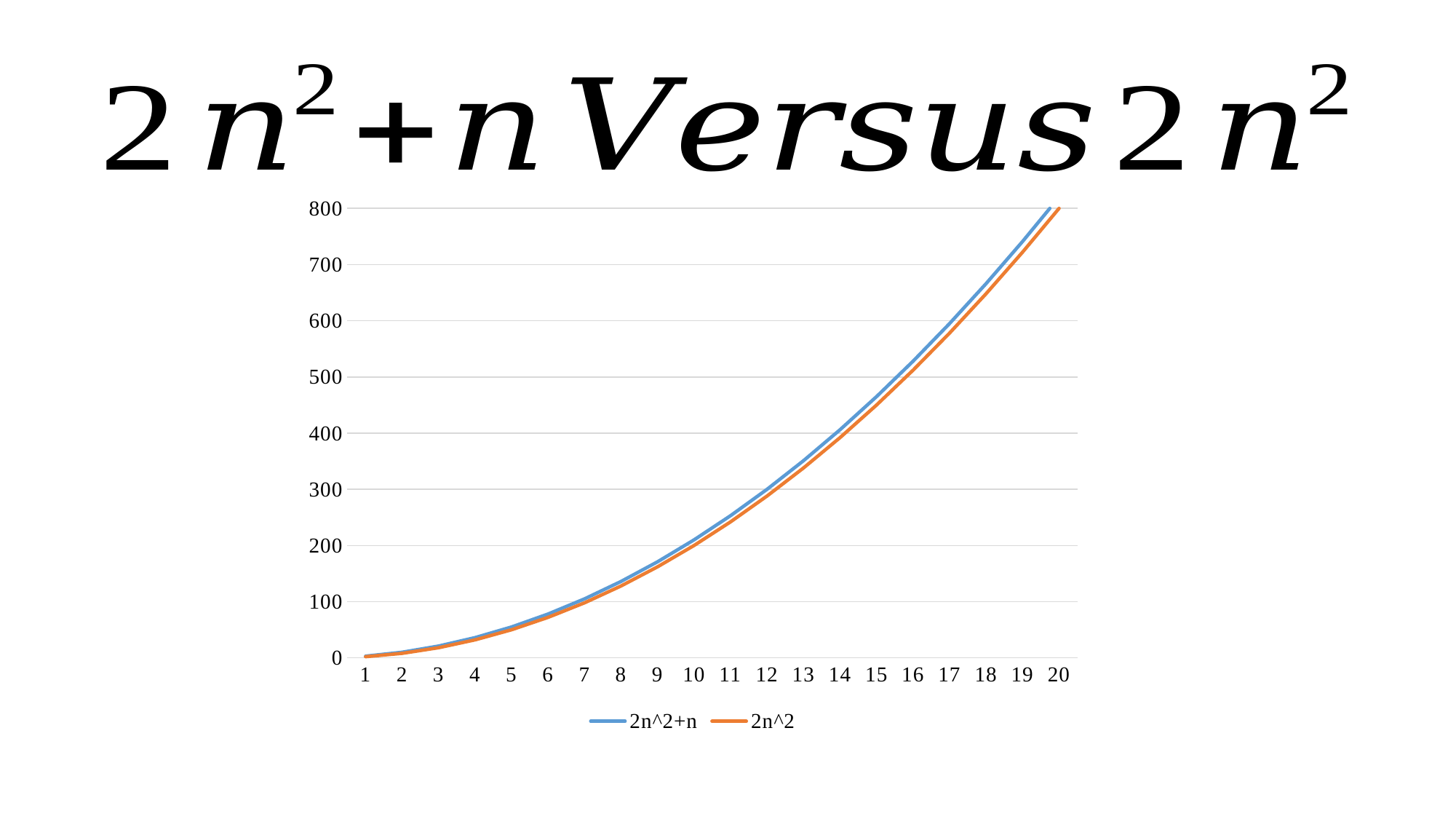
Is the value of the 2n^2 series at n = 5 greater or less than 100? less Do the values of the 2n^2+n series rise or fall as n increases along the x axis? rise Is the value of the 2n^2 series at n = 18 greater or less than 700? less What kind of chart is shown on the slide? line chart What are the two series names listed in the legend? 2n^2+n and 2n^2 What colour is the line for the 2n^2 series? orange Is the value of the 2n^2+n series at n = 8 greater or less than 200? less Which series is higher at n = 20, 2n^2+n or 2n^2? 2n^2+n How many points along the x axis does each series have? 20 How many series does the legend list? 2